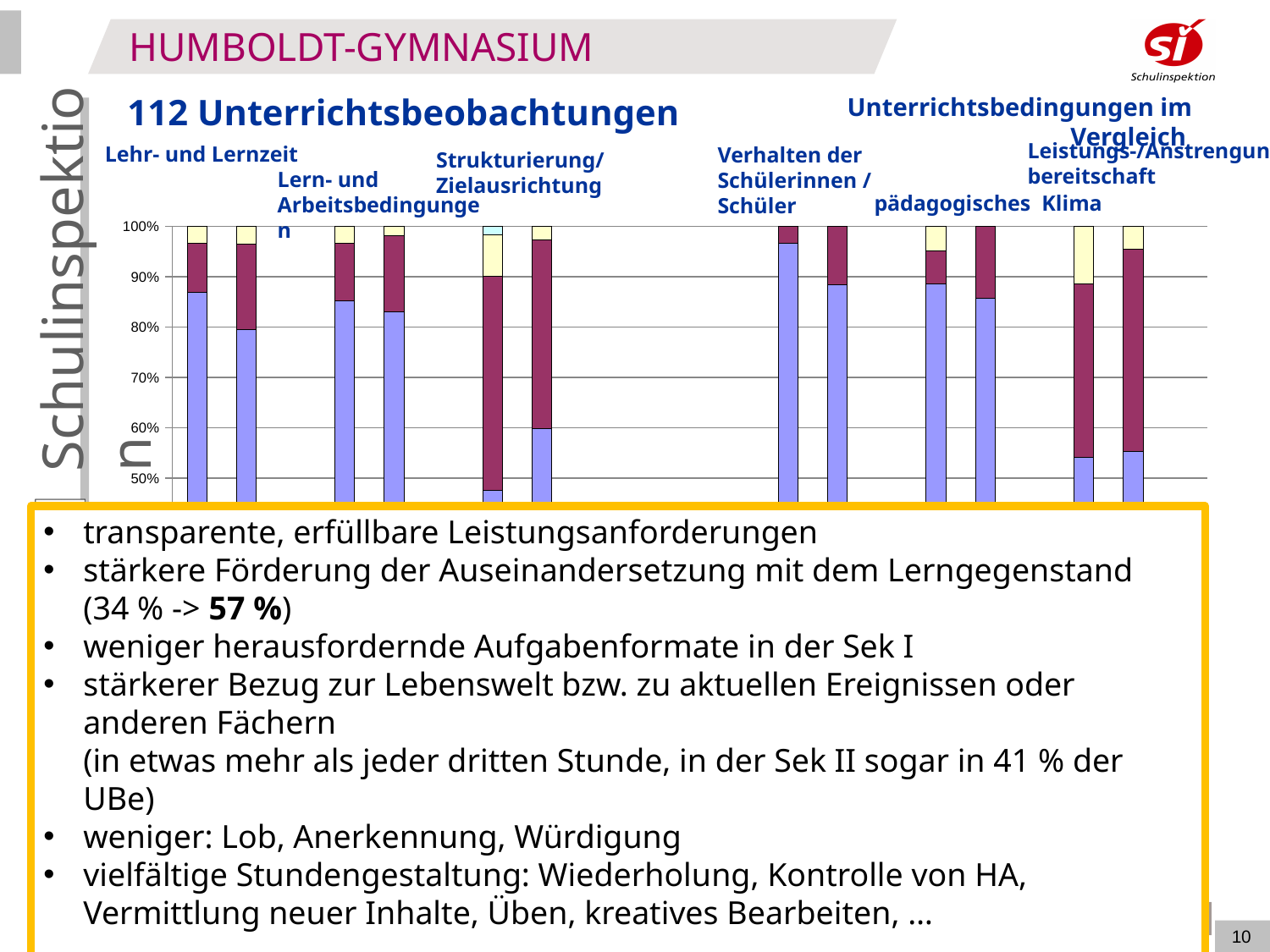
What kind of chart is shown on the slide? bar chart What is the lowest value shown on the chart's vertical axis? 50% Is the top of the blue segment in the first bar of the Lehr- und Lernzeit group greater or less than 80%? greater Which has the taller blue segment: the first bar of the Lehr- und Lernzeit group or the first bar of the Strukturierung/Zielausrichtung group? Lehr- und Lernzeit Is the top of the blue segment in the first bar of the Verhalten der Schülerinnen / Schüler group greater or less than 90%? greater How many labelled category groups does the chart show? 6 Is the top of the blue segment in the first bar of the Leistungs-/Anstrengungsbereitschaft group greater or less than 60%? less Which has the taller blue segment: the first bar of the Verhalten der Schülerinnen / Schüler group or the first bar of the Leistungs-/Anstrengungsbereitschaft group? Verhalten der Schülerinnen / Schüler